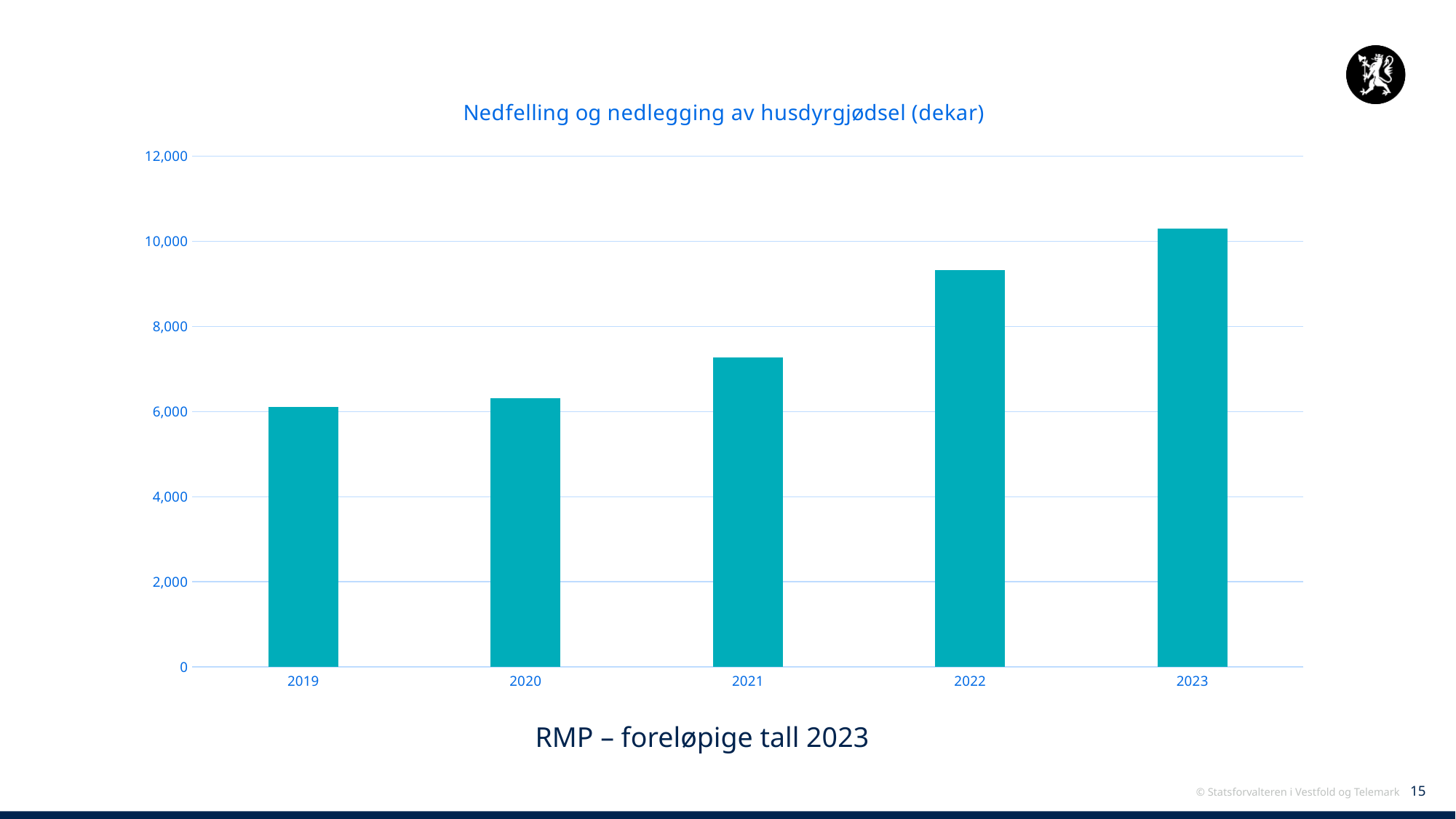
Which year has the highest value in the chart? 2023 Is the value for 2019 greater or less than 8,000? less Which is larger, the value for 2021 or the value for 2022? 2022 Is the value for 2022 greater or less than 10,000? less Is the value for 2022 greater or less than 8,000? greater Which is larger, the value for 2020 or the value for 2023? 2023 What kind of chart is shown on the slide? bar chart Do the values rise or fall from 2019 to 2023? rise What is the title of the chart? Nedfelling og nedlegging av husdyrgjødsel (dekar) How many years are shown on the x axis of the chart? 5